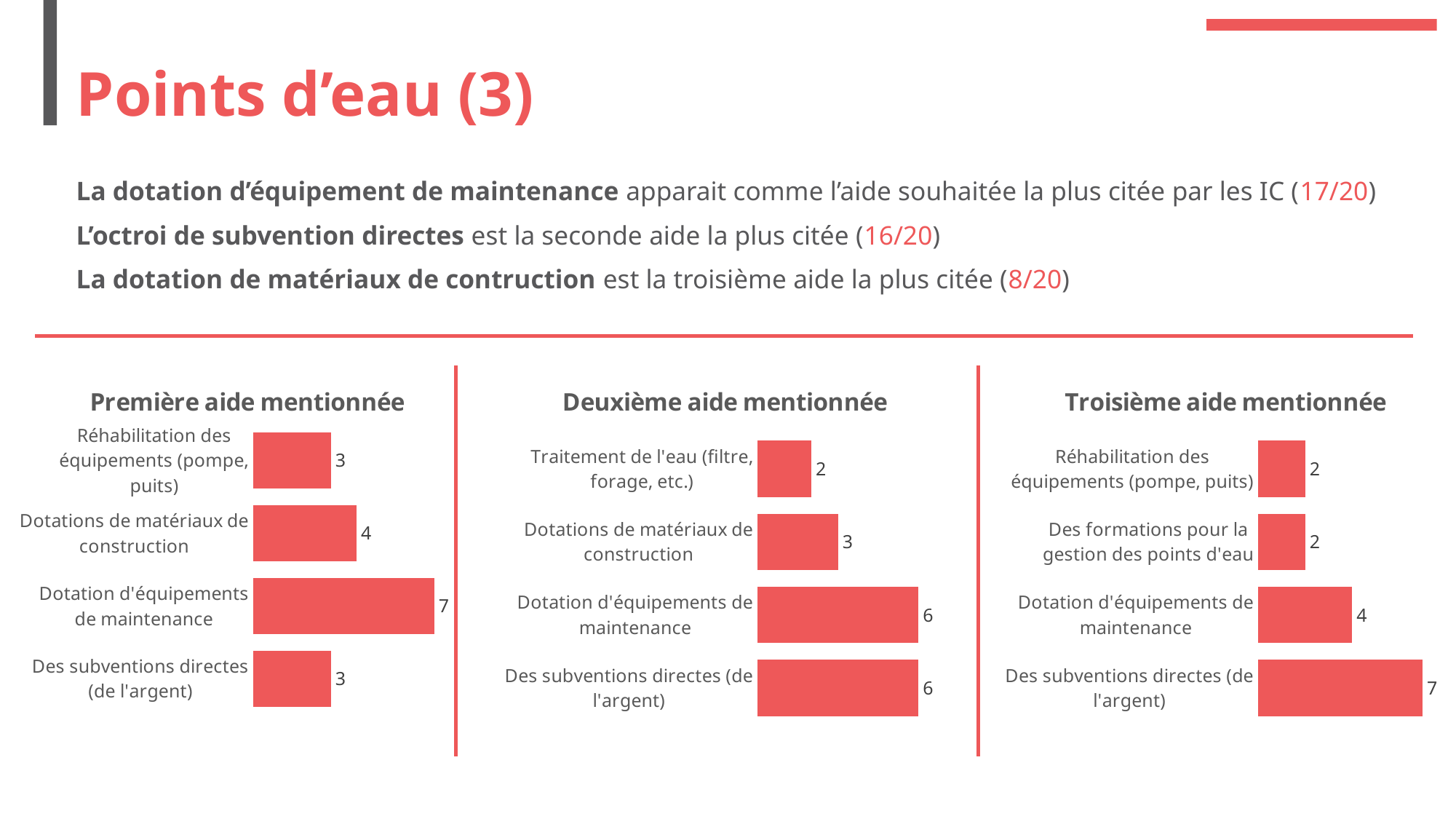
How many charts are shown on the slide? 3 In the 'Première aide mentionnée' chart, which category has the highest value? Dotation d'équipements de maintenance In the 'Deuxième aide mentionnée' chart, which category has the lowest value? Traitement de l'eau (filtre, forage, etc.) In the 'Troisième aide mentionnée' chart, what is the difference between 'Des subventions directes (de l'argent)' and 'Dotation d'équipements de maintenance'? 3 In the 'Deuxième aide mentionnée' chart, which is larger: 'Dotations de matériaux de construction' or 'Des subventions directes (de l'argent)'? Des subventions directes (de l'argent) In the 'Troisième aide mentionnée' chart, which category has the highest value? Des subventions directes (de l'argent) What kind of chart is the 'Troisième aide mentionnée' chart? Bar chart In the 'Première aide mentionnée' chart, what is the difference between 'Dotation d'équipements de maintenance' and 'Dotations de matériaux de construction'? 3 In the 'Deuxième aide mentionnée' chart, what is the value for 'Traitement de l'eau (filtre, forage, etc.)'? 2 In the 'Première aide mentionnée' chart, what is the value for 'Dotation d'équipements de maintenance'? 7 In the 'Troisième aide mentionnée' chart, what is the value for 'Des subventions directes (de l'argent)'? 7 In the 'Première aide mentionnée' chart, how many categories are shown? 4